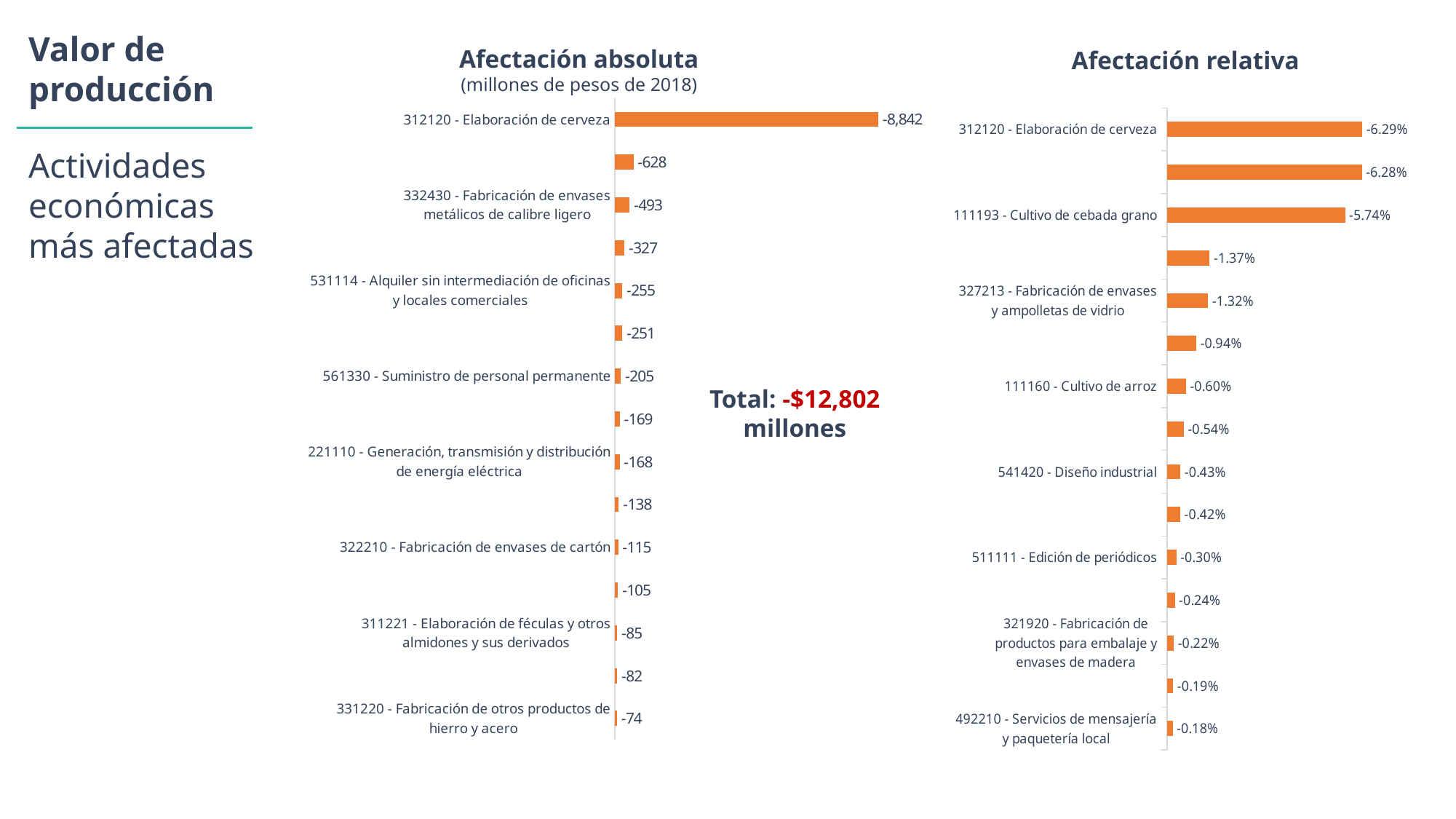
How many bars are plotted in the 'Afectación absoluta' chart? 15 In the 'Afectación relativa' chart, what is the value for 541420 - Diseño industrial? -0.43% In the 'Afectación absoluta' chart, what is the difference between the values for 332430 - Fabricación de envases metálicos de calibre ligero (-493) and 531114 - Alquiler sin intermediación de oficinas y locales comerciales (-255)? 238 In the 'Afectación relativa' chart, what is the value for 111193 - Cultivo de cebada grano? -5.74% In the 'Afectación absoluta' chart, what is the value for 561330 - Suministro de personal permanente? -205 In the 'Afectación absoluta' chart, which category has the largest negative value (longest bar)? 312120 - Elaboración de cerveza In the 'Afectación absoluta' chart, what is the value for 312120 - Elaboración de cerveza? -8,842 In the 'Afectación absoluta' chart, what is the value for 332430 - Fabricación de envases metálicos de calibre ligero? -493 In the 'Afectación relativa' chart, which has the longer bar: 111160 - Cultivo de arroz or 511111 - Edición de periódicos? 111160 - Cultivo de arroz What kind of chart is the 'Afectación relativa' chart? Bar chart In the 'Afectación relativa' chart, what is the value for 492210 - Servicios de mensajería y paquetería local? -0.18% What total is printed on the slide for the absolute affectation? -$12,802 millones